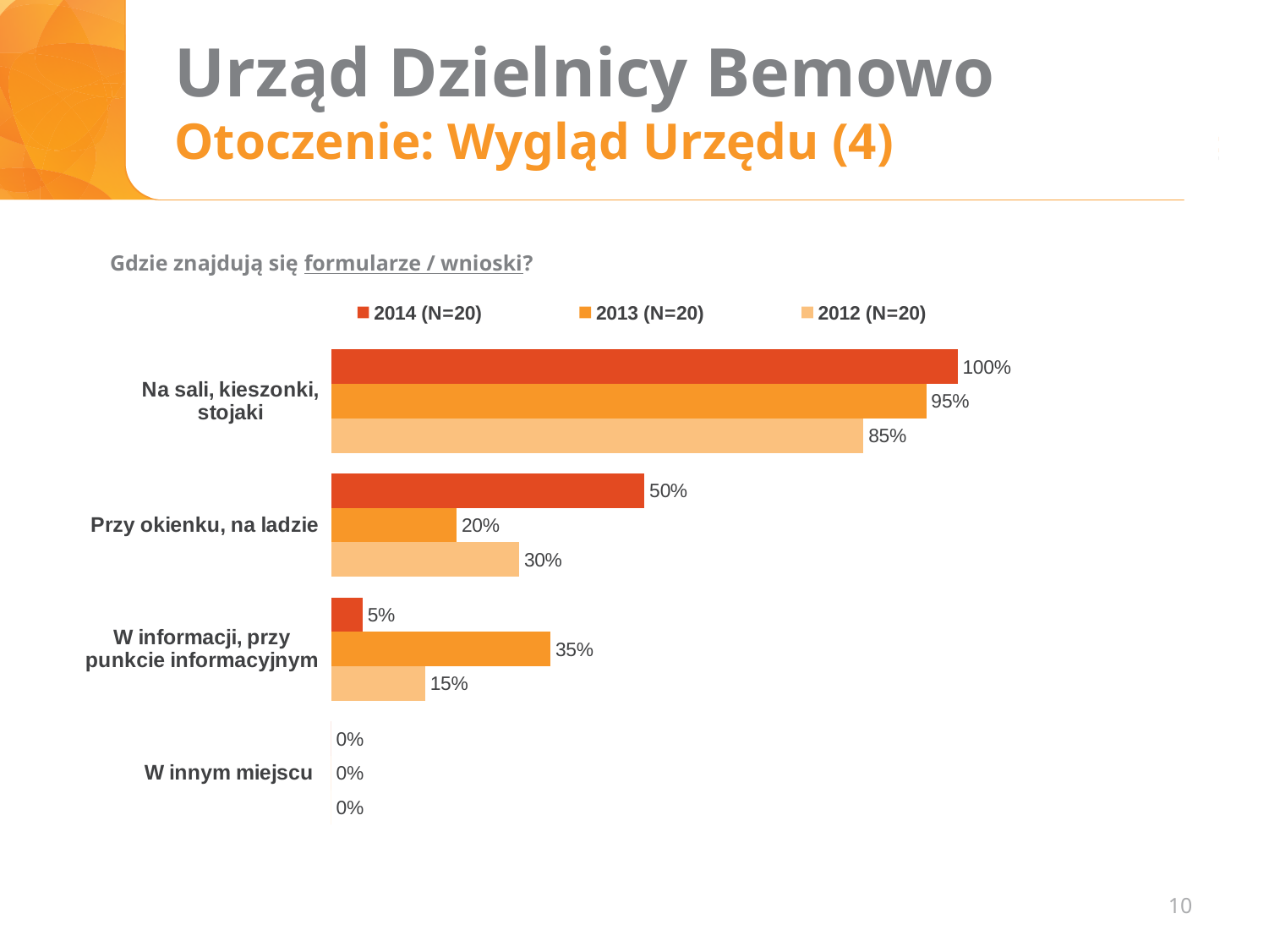
How many categories are shown on the chart? 4 What is the value for 'W informacji, przy punkcie informacyjnym' in the 2012 (N=20) series? 15% What is the value for 'Na sali, kieszonki, stojaki' in the 2014 (N=20) series? 100% How many series does the legend list? 3 Which category has the lowest value in the 2012 (N=20) series? W innym miejscu What is the value for 'Przy okienku, na ladzie' in the 2013 (N=20) series? 20% What kind of chart is shown on the slide? Bar chart Which is larger for 'W informacji, przy punkcie informacyjnym': the 2013 (N=20) value or the 2014 (N=20) value? 2013 (N=20) What is the value for 'W innym miejscu' in the 2014 (N=20) series? 0% What question does the chart answer, as stated above it? Gdzie znajdują się formularze / wnioski? What is the difference between the 2014 (N=20) and 2013 (N=20) values for 'Przy okienku, na ladzie'? 30 percentage points Which category has the highest value in the 2013 (N=20) series? Na sali, kieszonki, stojaki